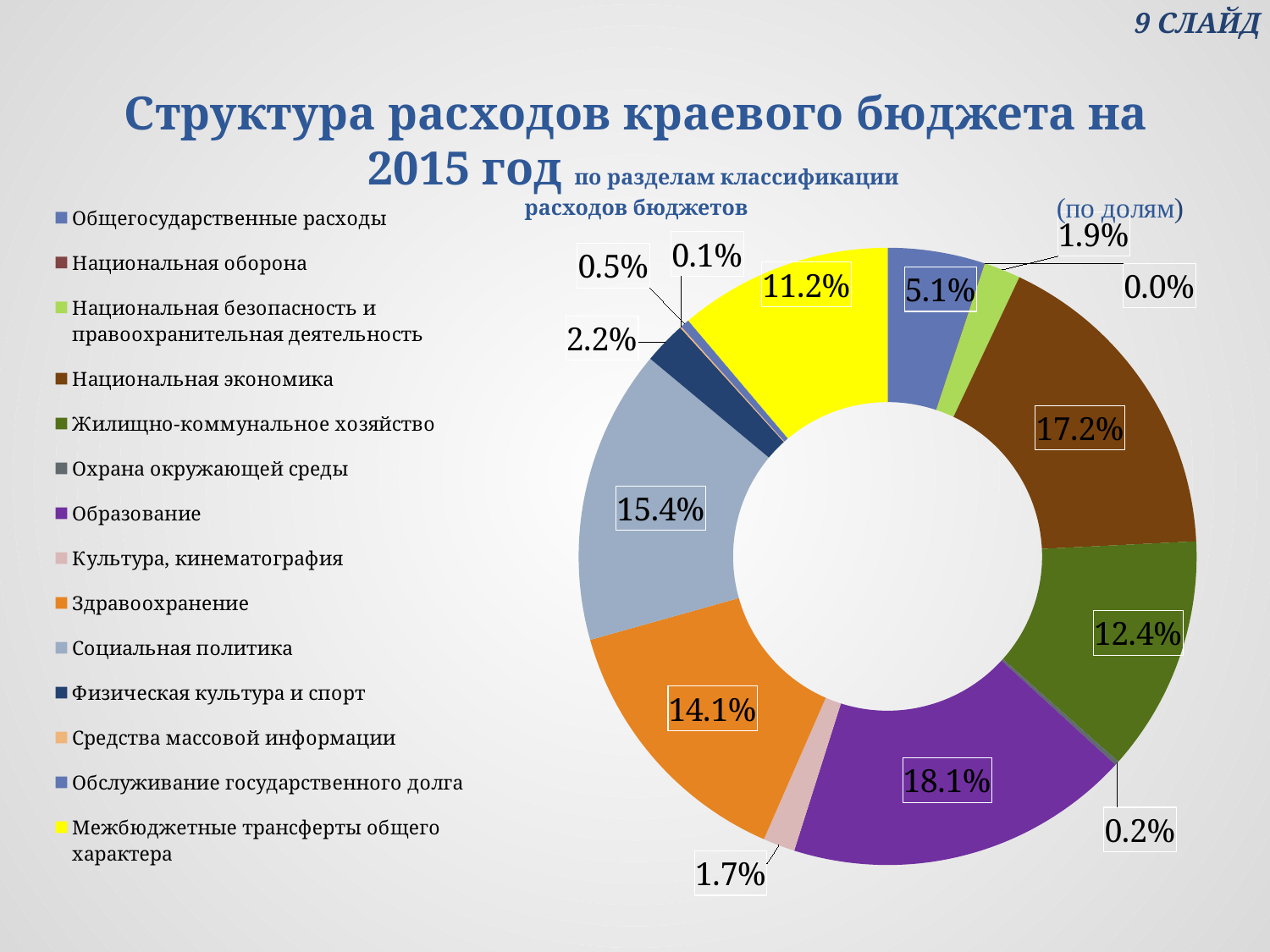
Which section has the largest share of the budget expenditure? Образование What share of the budget expenditure goes to Здравоохранение? 14.1% What is the difference between the shares of Образование and Жилищно-коммунальное хозяйство? 5.7% Which has a larger share: Социальная политика or Здравоохранение? Социальная политика What kind of chart is shown on the slide? doughnut (pie) chart What colour is the slice for Межбюджетные трансферты общего характера? yellow What share of the budget expenditure goes to Образование? 18.1% What share of the budget expenditure goes to Национальная экономика? 17.2% What share of the budget expenditure goes to Социальная политика? 15.4% How many sections are listed in the legend of the chart? 14 What share of the budget expenditure goes to Межбюджетные трансферты общего характера? 11.2% Which section has the smallest share of the budget expenditure? Национальная оборона